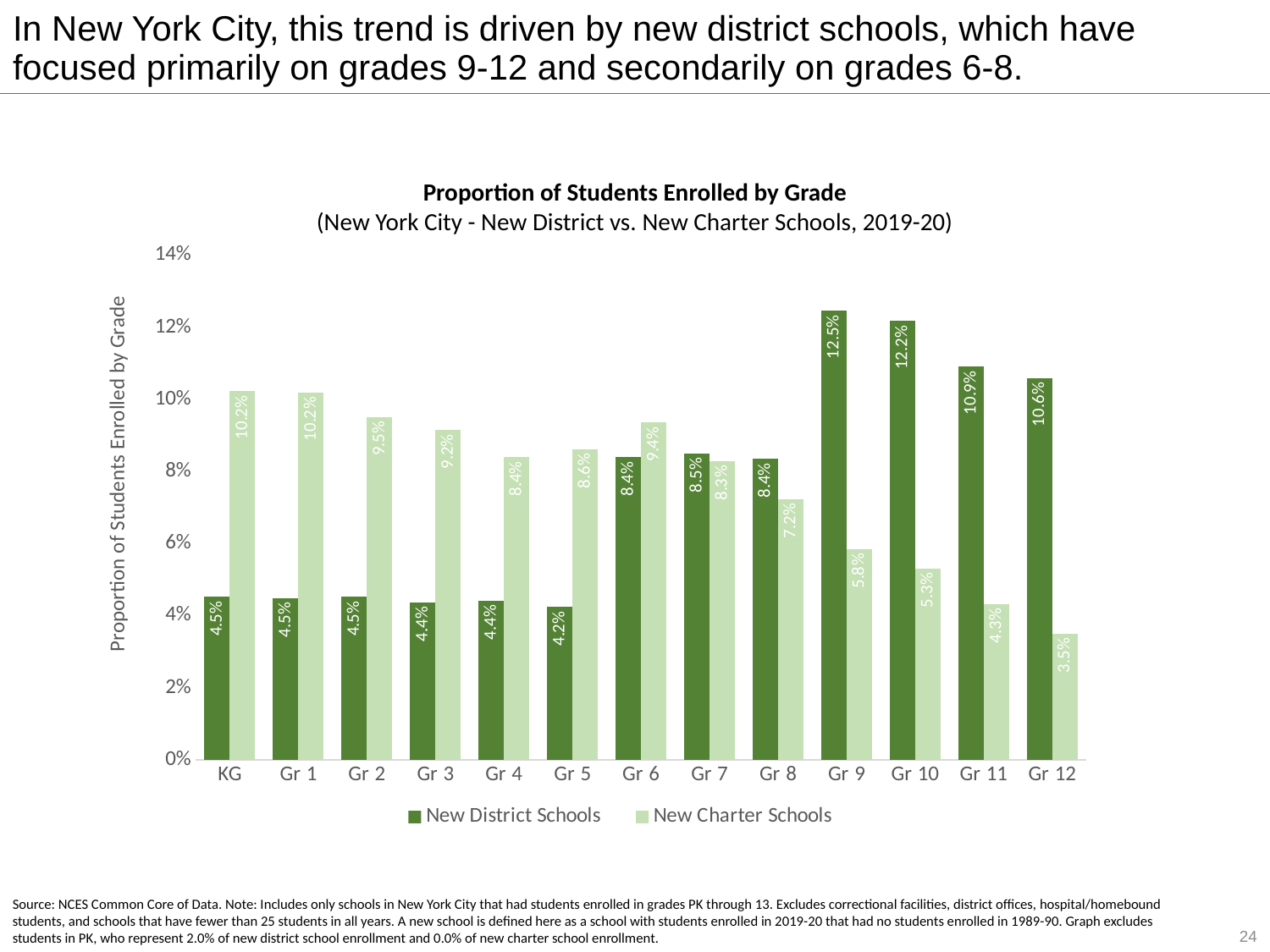
What is the value for New District Schools at Gr 5? 4.2% What is the title of the chart? Proportion of Students Enrolled by Grade Which grade has the highest value for New District Schools? Gr 9 At Gr 6, which series has the larger value, New District Schools or New Charter Schools? New Charter Schools How many grade categories are shown on the x axis? 13 Which grade has the lowest value for New Charter Schools? Gr 12 How many series does the legend list? 2 What is the difference between New District Schools and New Charter Schools at Gr 9? 6.7 percentage points What is the value for New Charter Schools at KG? 10.2% What kind of chart is shown on the slide? Bar chart Do the values for New Charter Schools rise or fall from Gr 6 to Gr 12? Fall What is the value for New District Schools at Gr 9? 12.5%